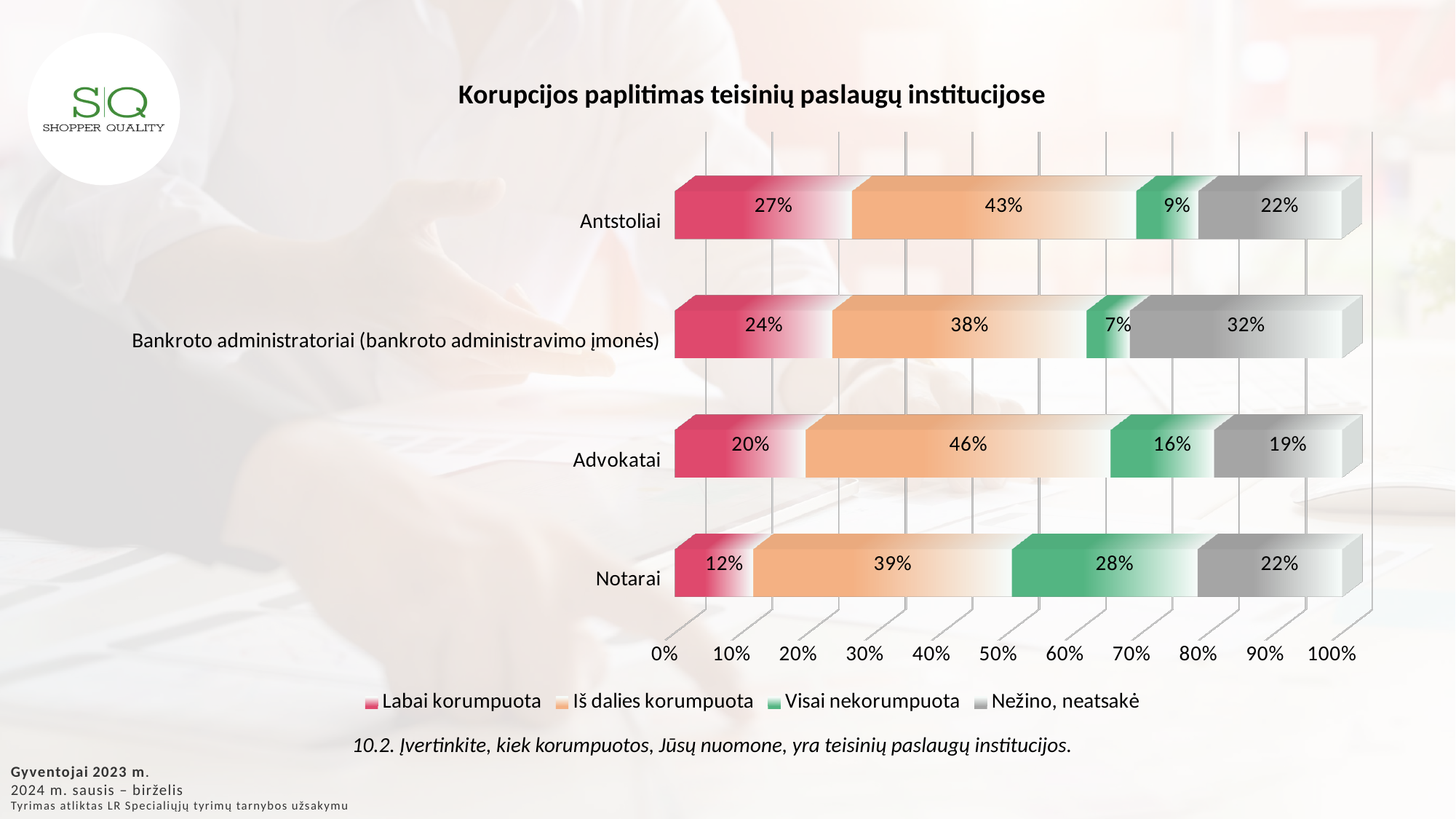
Which category has the highest 'Labai korumpuota' value? Antstoliai What is the difference between the 'Visai nekorumpuota' values for Notarai and Advokatai? 12% Which is larger: the 'Iš dalies korumpuota' value for Antstoliai or for Notarai? Antstoliai What is the 'Iš dalies korumpuota' value for Advokatai? 46% What is the 'Visai nekorumpuota' value for Notarai? 28% What is the 'Labai korumpuota' value for Antstoliai? 27% What is the title of the chart? Korupcijos paplitimas teisinių paslaugų institucijose How many categories are shown on the chart? 4 What is the 'Nežino, neatsakė' value for Bankroto administratoriai (bankroto administravimo įmonės)? 32% What type of chart is shown on the slide? Stacked bar chart Which category has the lowest 'Visai nekorumpuota' value? Bankroto administratoriai (bankroto administravimo įmonės) How many series does the legend list? 4